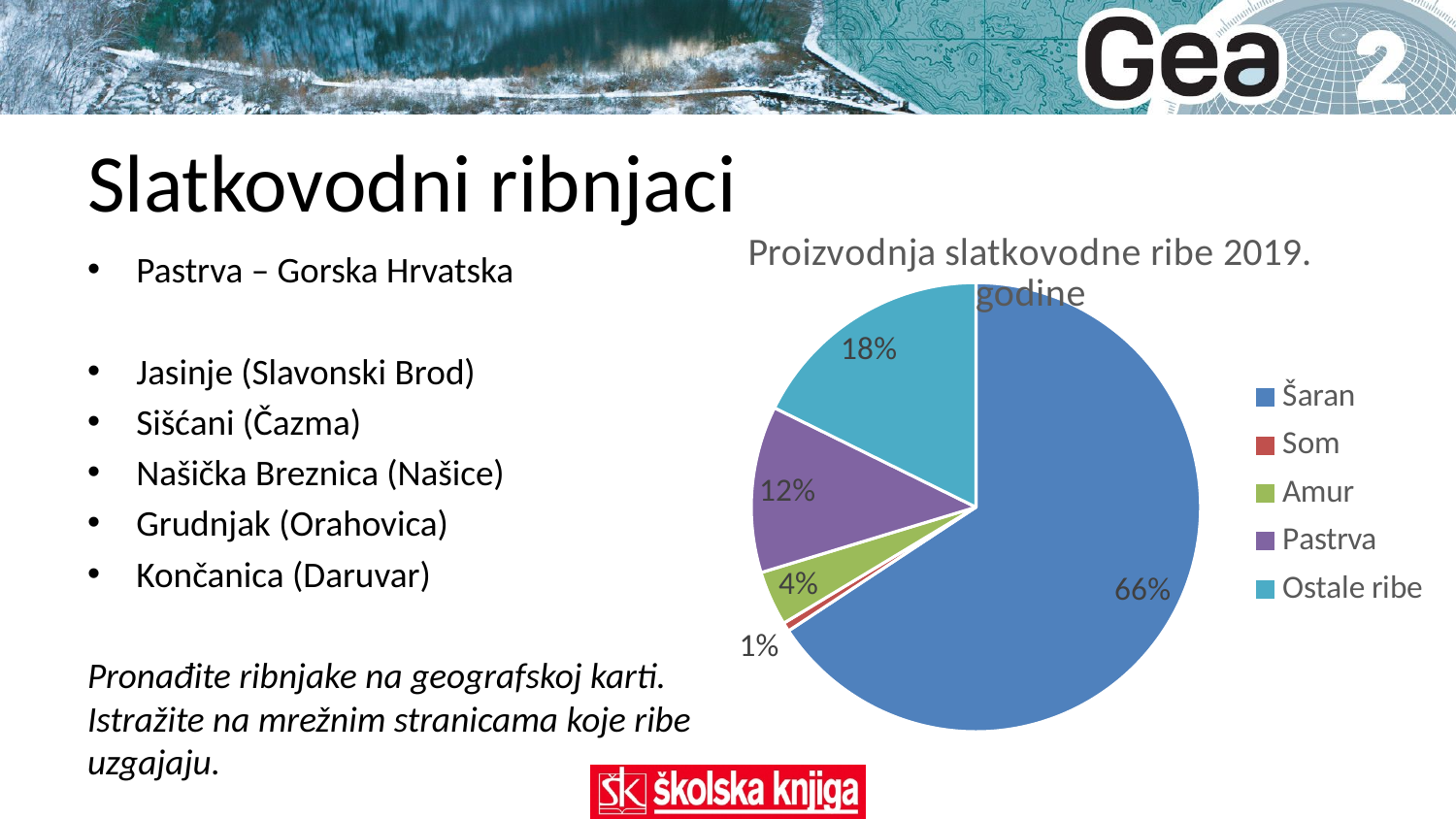
What share of the pie does Amur have? 4% What is the difference in percentage points between the Ostale ribe slice and the Pastrva slice? 6 What share of the pie does Ostale ribe have? 18% What share of the pie does Pastrva have? 12% What is the title of the chart? Proizvodnja slatkovodne ribe 2019. godine Which category has the smallest slice of the pie? Som How many categories does the legend of the pie chart list? 5 Which slice is larger, Amur or Pastrva? Pastrva What kind of chart is shown on the slide? pie chart Which category has the largest slice of the pie? Šaran